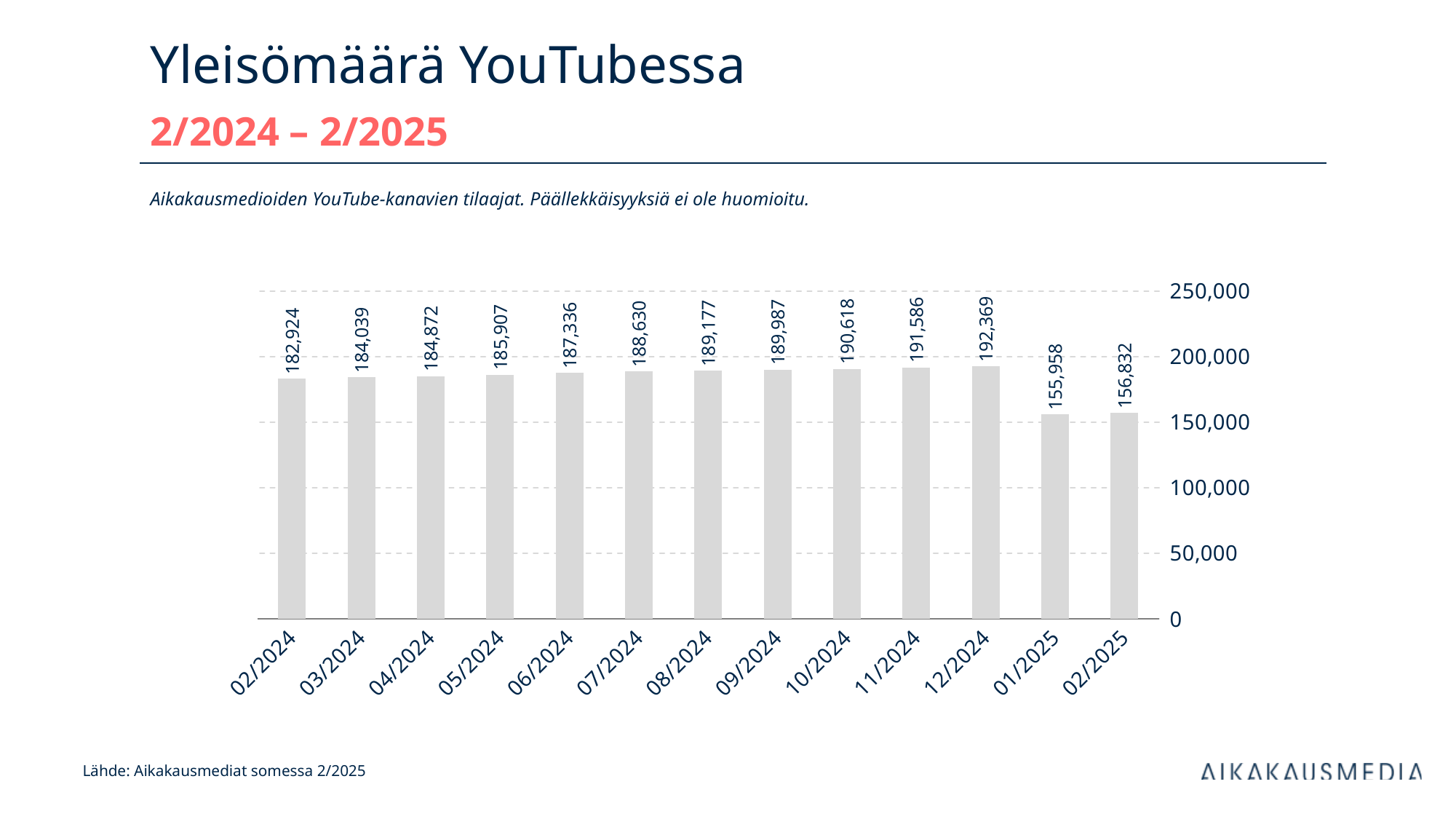
What kind of chart is shown on the slide? bar chart What is the value for 01/2025? 155,958 Do the values rise or fall from 02/2024 to 12/2024? rise Which month has the highest value? 12/2024 How many months are shown on the x axis? 13 What is the difference between the values for 12/2024 and 01/2025? 36,411 Is the value for 01/2025 greater or less than 200,000? less Which is larger, the value for 02/2024 or the value for 02/2025? 02/2024 What is the difference between the values for 02/2025 and 01/2025? 874 Which month has the lowest value? 01/2025 What is the value for 12/2024? 192,369 What is the value for 02/2024? 182,924